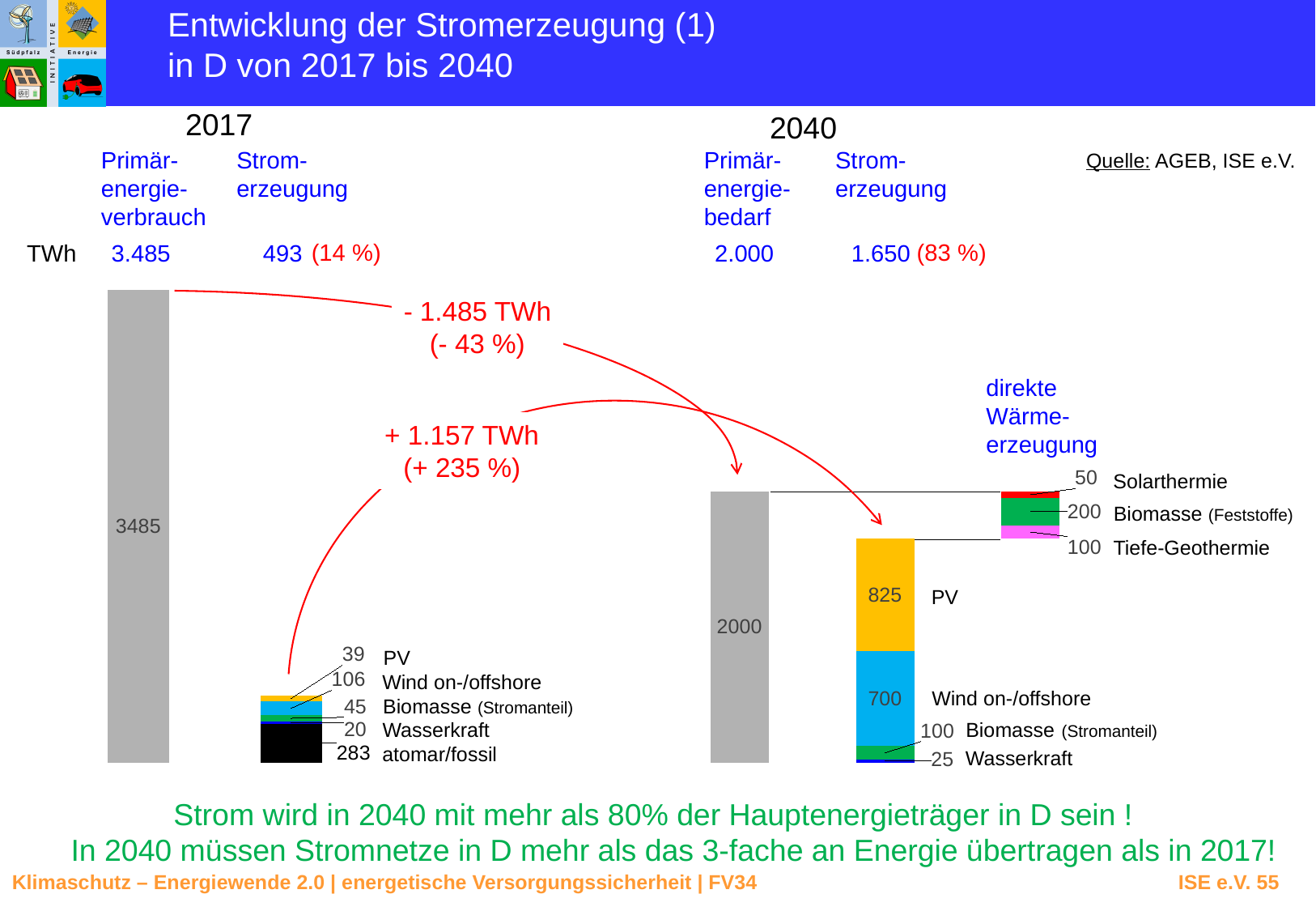
By how much does the PV value in 2040 exceed the PV value in 2017? 786 In the 2040 Stromerzeugung bar, what is the value for Wind on-/offshore? 700 In the 2017 Stromerzeugung bar, which segment is the largest? atomar/fossil What value is printed on the 2040 Primärenergiebedarf bar? 2000 In the 2017 Stromerzeugung bar, which segment is the smallest? Wasserkraft In the 2040 Stromerzeugung bar, which is larger: Wind on-/offshore or Biomasse (Stromanteil)? Wind on-/offshore In the 2040 direkte Wärmeerzeugung bar, what is the value for Tiefe-Geothermie? 100 In the 2040 Stromerzeugung bar, which segment is the largest? PV In the 2017 Stromerzeugung bar, what is the value for PV? 39 What kind of chart is used to show the Stromerzeugung values on the slide? Stacked bar chart How many segments make up the 2017 Stromerzeugung bar? 5 What is the total of the 2040 direkte Wärmeerzeugung bar (Solarthermie, Biomasse, Tiefe-Geothermie)? 350